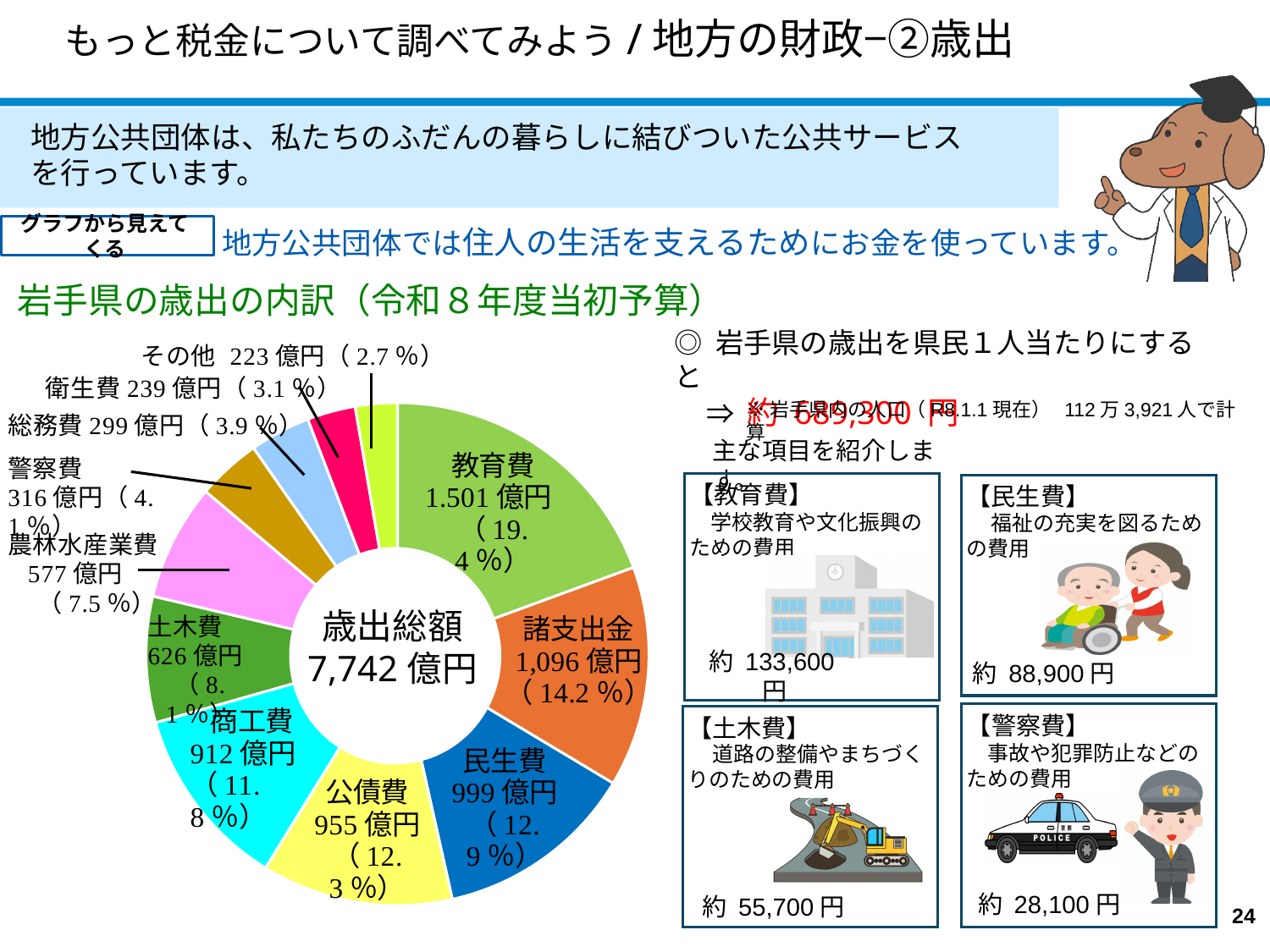
円グラフにはいくつの項目が示されていますか？ 11 円グラフで商工費が歳出全体に占める割合は何％ですか？ 11.8 % 円グラフで最も割合が大きい項目はどれですか？ 教育費 このスライドのグラフはどの種類のグラフですか？ 円グラフ（ドーナツグラフ） 円グラフで最も金額が小さい項目はどれですか？ その他 円グラフで商工費と土木費では、どちらの金額が大きいですか？ 商工費 円グラフで民生費の金額はいくらですか？ 999 億円 円グラフで公債費の金額はいくらですか？ 955 億円 円グラフで教育費が歳出全体に占める割合は何％ですか？ 19.4 % 円グラフの中央に示されている歳出総額はいくらですか？ 7,742 億円 円グラフで諸支出金と民生費の金額の差はいくらですか？ 97 億円 円グラフで警察費の金額はいくらですか？ 316 億円